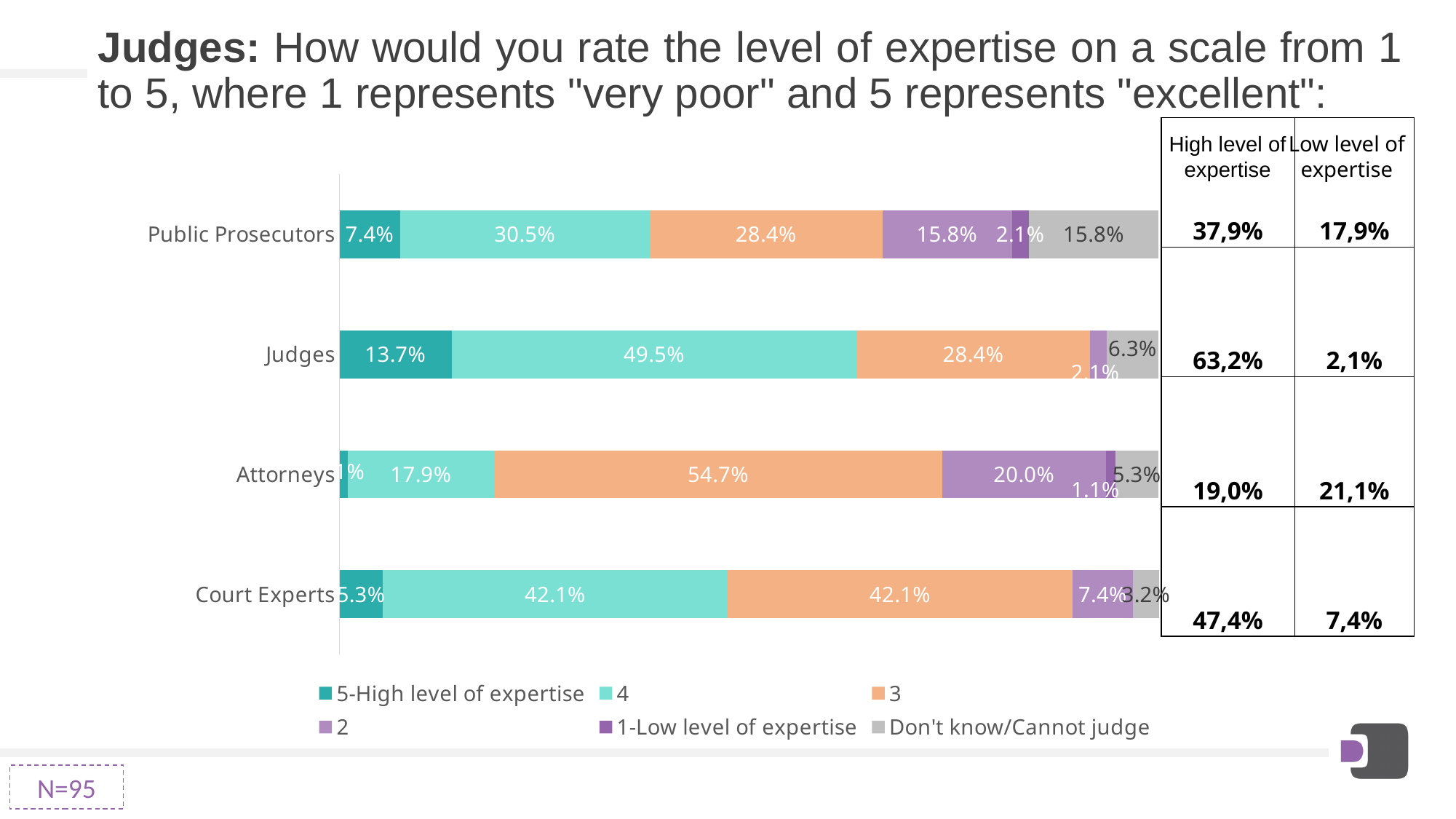
What percentage of respondents gave Court Experts a rating of 2? 7.4% What is the 'Don't know/Cannot judge' share for Public Prosecutors? 15.8% What type of chart is shown on the slide? Stacked bar chart How much larger is the share of 4 ratings for Judges than for Public Prosecutors? 19.0% How many series does the legend list? 6 What percentage of respondents rated Judges with a 4? 49.5% Which has a larger share of ratings of 2: Public Prosecutors or Attorneys? Attorneys Which category has the highest share of ratings of 3? Attorneys How many categories (groups of professionals) are shown in the chart? 4 What percentage of respondents rated Attorneys with a 3? 54.7% Which category has the lowest 'Don't know/Cannot judge' share? Court Experts Which category has the highest share of '5-High level of expertise' ratings? Judges